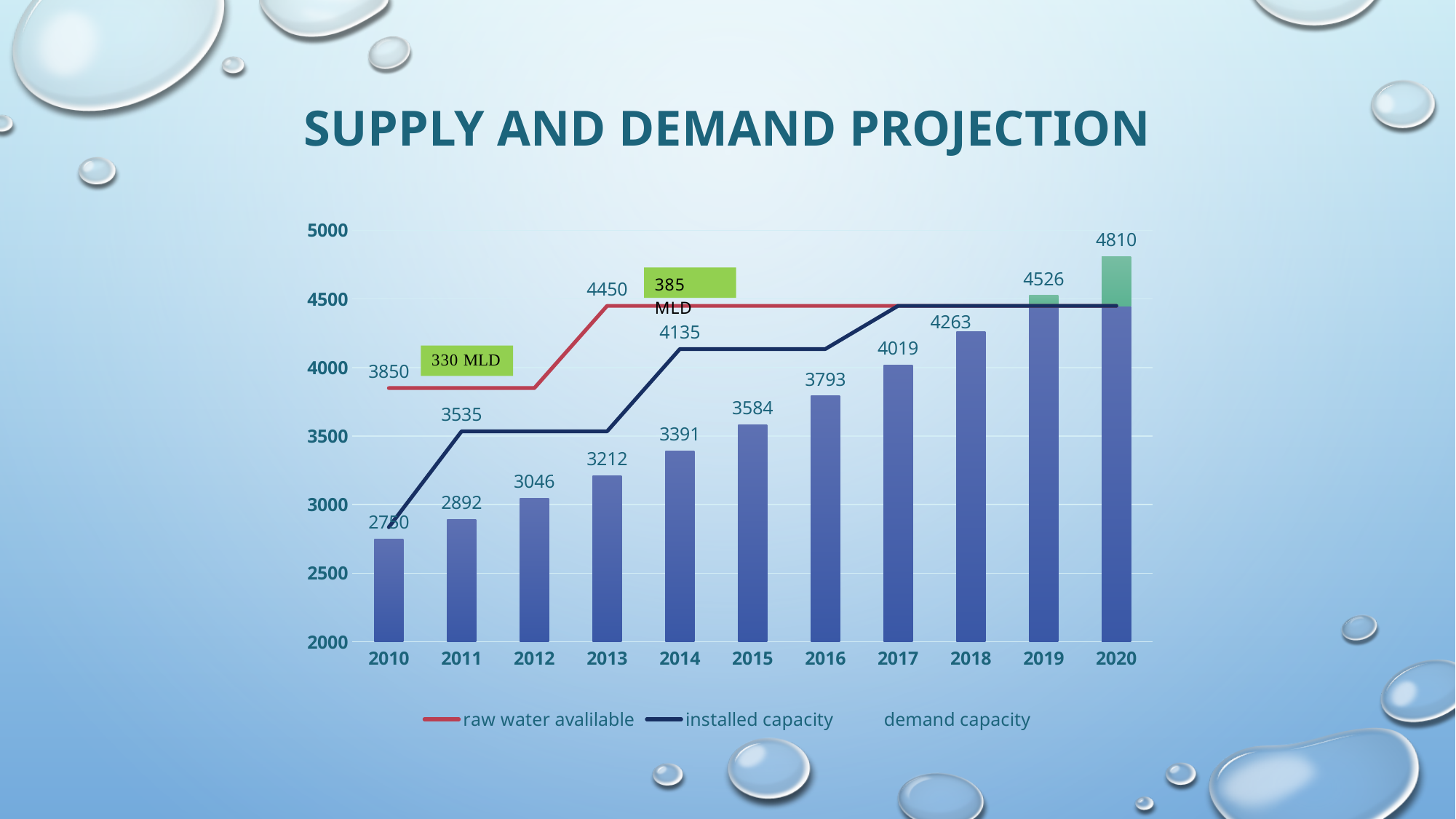
What is the demand capacity value for 2010? 2750 What is the demand capacity value for 2015? 3584 How many years are shown on the x axis? 11 Which year has the highest demand capacity? 2020 Do the demand capacity bars rise or fall from 2010 to 2020? rise Which year has the lowest demand capacity? 2010 What is the title of the chart? Supply and Demand Projection Which is larger, the demand capacity in 2017 or in 2016? 2017 What is the demand capacity value for 2020? 4810 Is the demand capacity for 2014 greater or less than 3500? less What is the difference between the demand capacity in 2019 and in 2018? 263 How many series does the legend list? 3